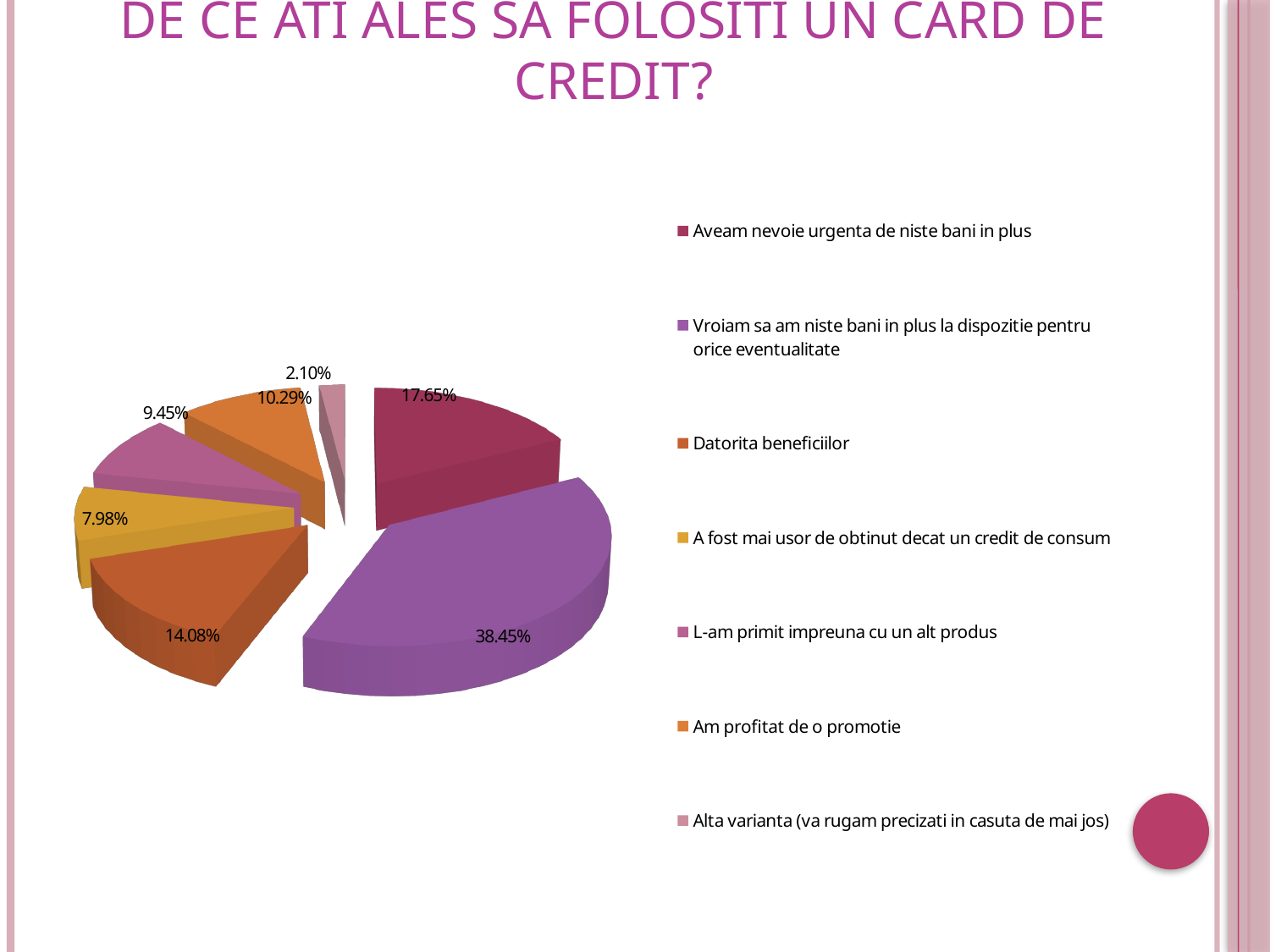
What percentage is shown for "Aveam nevoie urgenta de niste bani in plus"? 17.65% What percentage is shown for "Vroiam sa am niste bani in plus la dispozitie pentru orice eventualitate"? 38.45% What kind of chart is shown on the slide? pie chart What percentage is shown for "A fost mai usor de obtinut decat un credit de consum"? 7.98% Which category has the largest share of the pie? Vroiam sa am niste bani in plus la dispozitie pentru orice eventualitate How many entries does the legend list? 7 What is the difference in percentage points between "Vroiam sa am niste bani in plus la dispozitie pentru orice eventualitate" and "Aveam nevoie urgenta de niste bani in plus"? 20.80 Which category has the smallest share of the pie? Alta varianta (va rugam precizati in casuta de mai jos) How many slices does the pie chart have? 7 What percentage is shown for "Datorita beneficiilor"? 14.08% What percentage is shown for "Alta varianta (va rugam precizati in casuta de mai jos)"? 2.10% Which is larger: the share for "Am profitat de o promotie" or the share for "L-am primit impreuna cu un alt produs"? Am profitat de o promotie